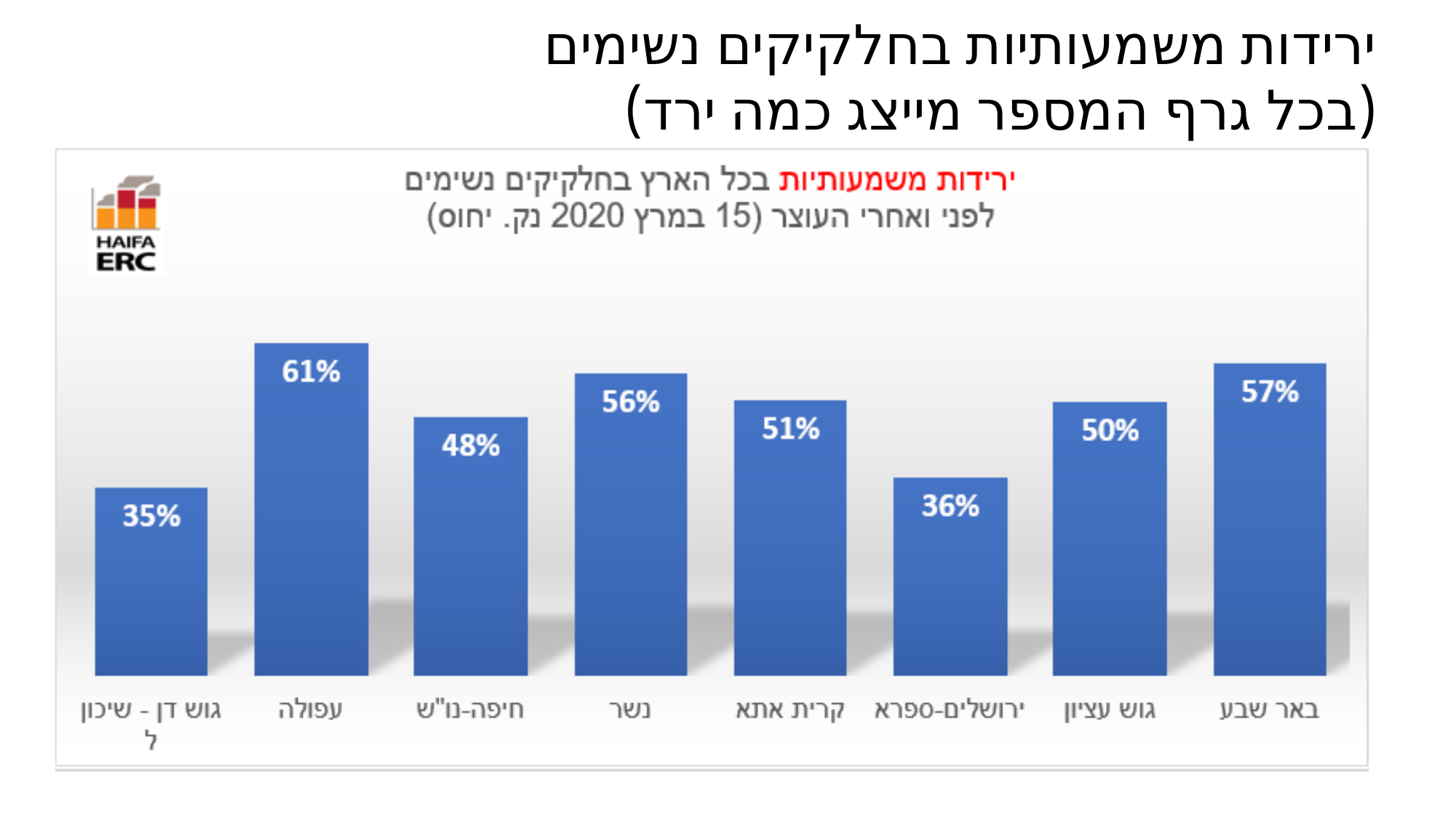
What is the value shown for באר שבע? 57% What is the difference between the values for נשר and חיפה-נו"ש? 8% What is the value shown for גוש עציון? 50% What colour are the bars in the chart? Blue How many categories are shown in the chart? 8 Which has a larger value, קרית אתא or ירושלים-ספרא? קרית אתא Which category has the lowest value? גוש דן - שיכון ל What is the value shown for עפולה? 61% Which category has the highest value? עפולה What is the difference between the values for עפולה and גוש דן - שיכון ל? 26% What kind of chart is shown on the slide? Bar chart What is the value shown for ירושלים-ספרא? 36%